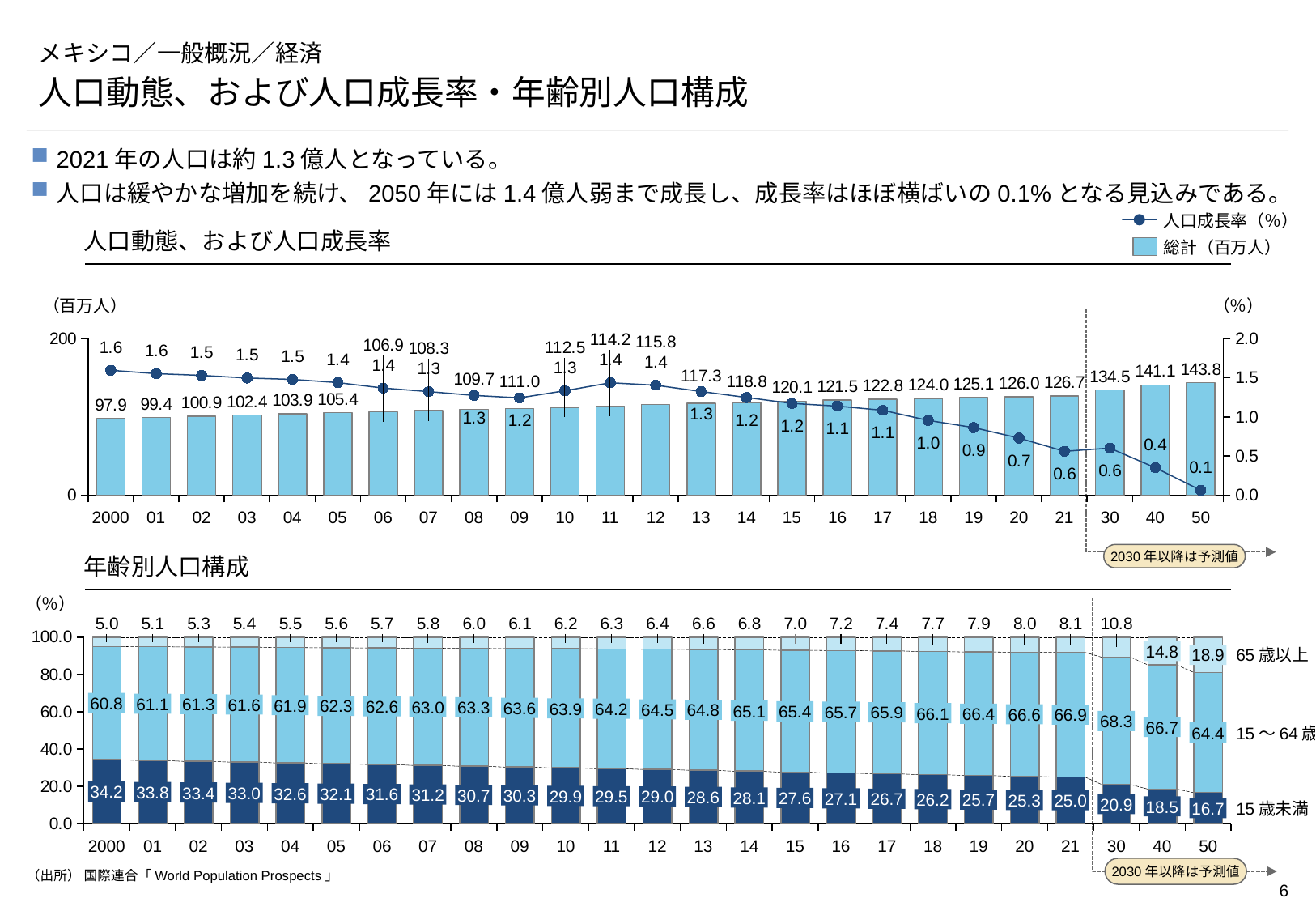
How many age groups (series) are shown in the 年齢別人口構成 chart? 3 In the 年齢別人口構成 chart, what is the share of 65歳以上 in 2050? 18.9 In the 人口動態、および人口成長率 chart, does the population growth rate line generally rise or fall from 2000 to 2050? fall In the 人口動態、および人口成長率 chart, what is the total population (総計) shown for 2021? 126.7 In the 人口動態、および人口成長率 chart, how many years are plotted along the x axis? 25 In the 人口動態、および人口成長率 chart, which year has the highest total population? 2050 In the 年齢別人口構成 chart, is the share of 15歳未満 larger in 2000 or in 2050? 2000 In the 人口動態、および人口成長率 chart, what is the population growth rate (人口成長率) shown for 2050? 0.1 In the 年齢別人口構成 chart, what is the share of 15歳未満 in 2000? 34.2 What kind of chart is the 年齢別人口構成 chart? stacked bar chart In the 人口動態、および人口成長率 chart, which year has the lowest population growth rate? 2050 In the 人口動態、および人口成長率 chart, what is the difference between the total population in 2050 and in 2021? 17.1